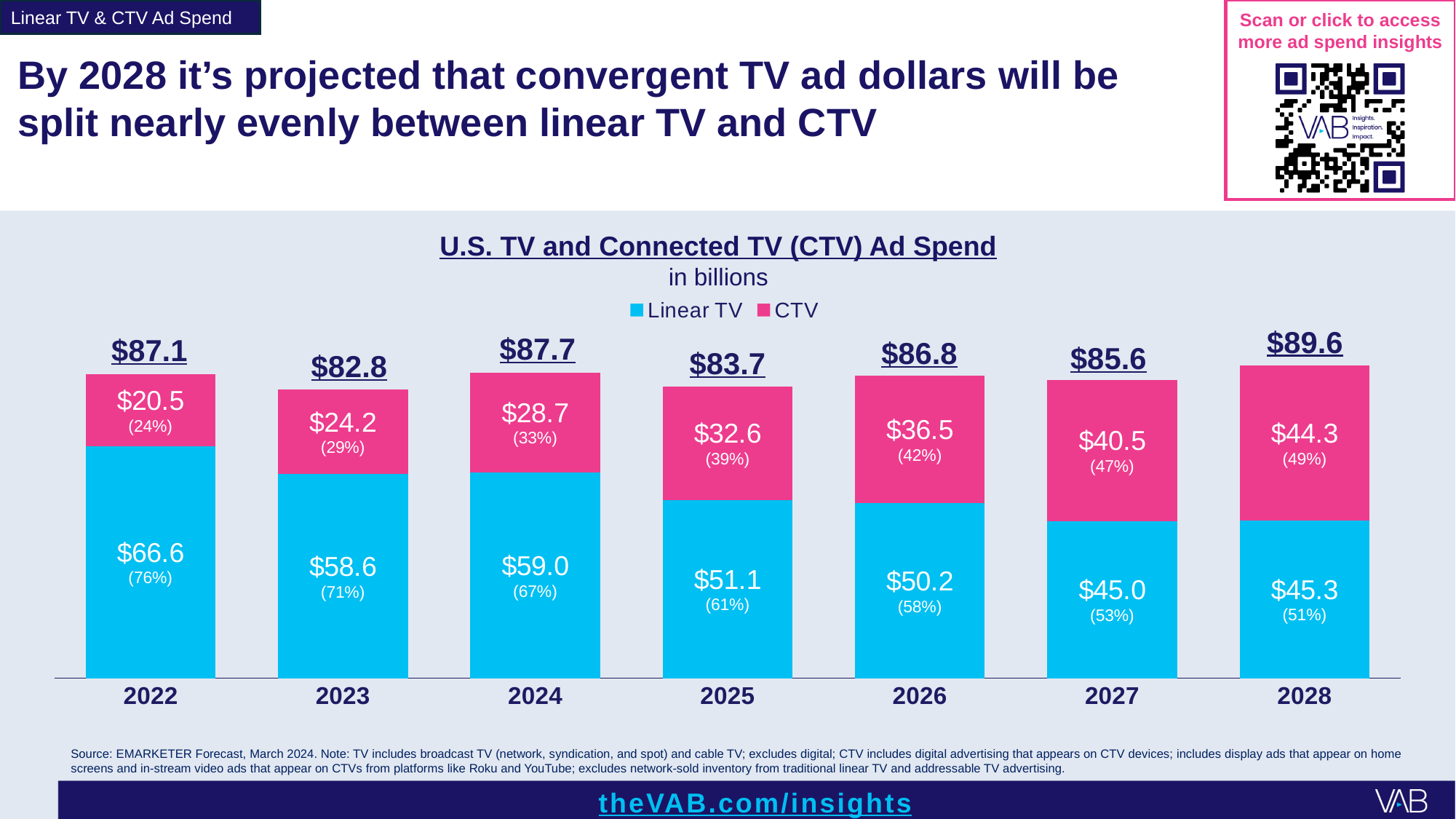
How many years are shown on the x axis? 7 What is the difference between the Linear TV value in 2022 and the Linear TV value in 2028? $21.3 How many series does the legend list? 2 What percentage share of the 2024 total does CTV account for? 33% What is the total ad spend shown above the 2025 bar? $83.7 Which year has the highest total ad spend? 2028 Which year has the lowest total ad spend? 2023 What is the Linear TV ad spend value for 2022? $66.6 Which is larger in 2026, the Linear TV value or the CTV value? Linear TV What kind of chart is shown on the slide? Stacked bar chart Does the CTV ad spend rise or fall from 2022 to 2028? Rise What is the CTV ad spend value for 2028? $44.3